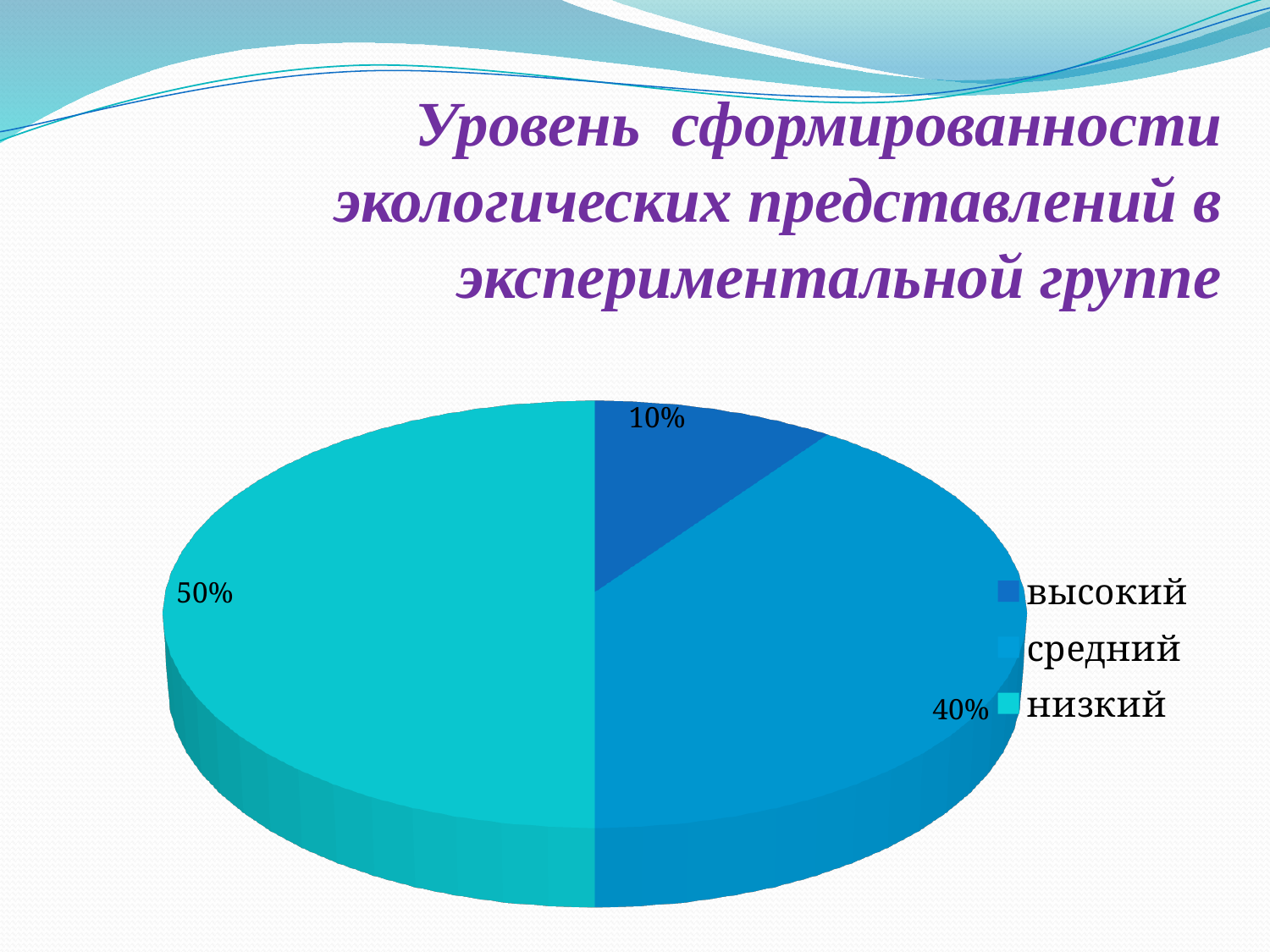
Which legend entry is shown in the darkest blue colour? высокий What is the difference between the 'низкий' and 'высокий' shares? 40% What share of the pie does the 'высокий' slice have? 10% What kind of chart is shown on the slide? pie chart Which is larger, the 'средний' slice or the 'высокий' slice? средний How many entries does the legend list? 3 What is the difference between the 'низкий' and 'средний' shares? 10% What share of the pie does the 'низкий' slice have? 50% Which category has the smallest slice of the pie? высокий How many categories does the pie chart have? 3 Which category has the largest slice of the pie? низкий What share of the pie does the 'средний' slice have? 40%